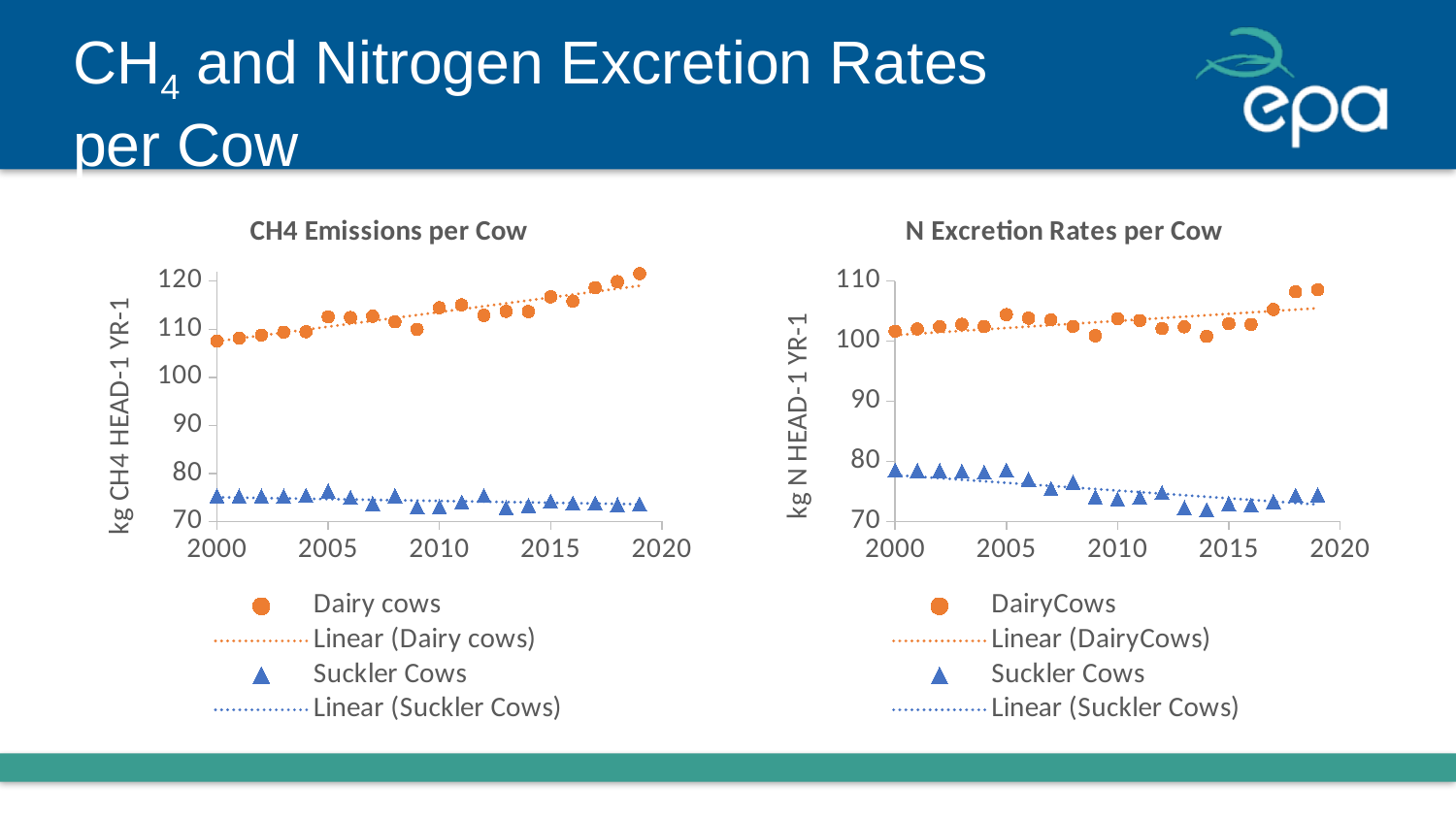
In the 'N Excretion Rates per Cow' chart, which series has the larger value in 2010, DairyCows or Suckler Cows? DairyCows In the 'CH4 Emissions per Cow' chart, do the Dairy cows values rise or fall from 2000 to 2019? rise How many entries does the legend of the 'N Excretion Rates per Cow' chart list? 4 What kind of chart is the 'CH4 Emissions per Cow' chart on the left? scatter chart In the 'CH4 Emissions per Cow' chart, is the Dairy cows value for 2019 greater or less than 110? greater In the 'N Excretion Rates per Cow' chart, do the Suckler Cows values rise or fall from 2000 to 2019? fall In the 'N Excretion Rates per Cow' chart, is the Suckler Cows value for 2019 greater or less than 80? less In the 'N Excretion Rates per Cow' chart, is the DairyCows value for 2019 greater or less than 100? greater What is the y-axis label of the 'CH4 Emissions per Cow' chart? kg CH4 HEAD-1 YR-1 What is the title of the chart on the right of the slide? N Excretion Rates per Cow